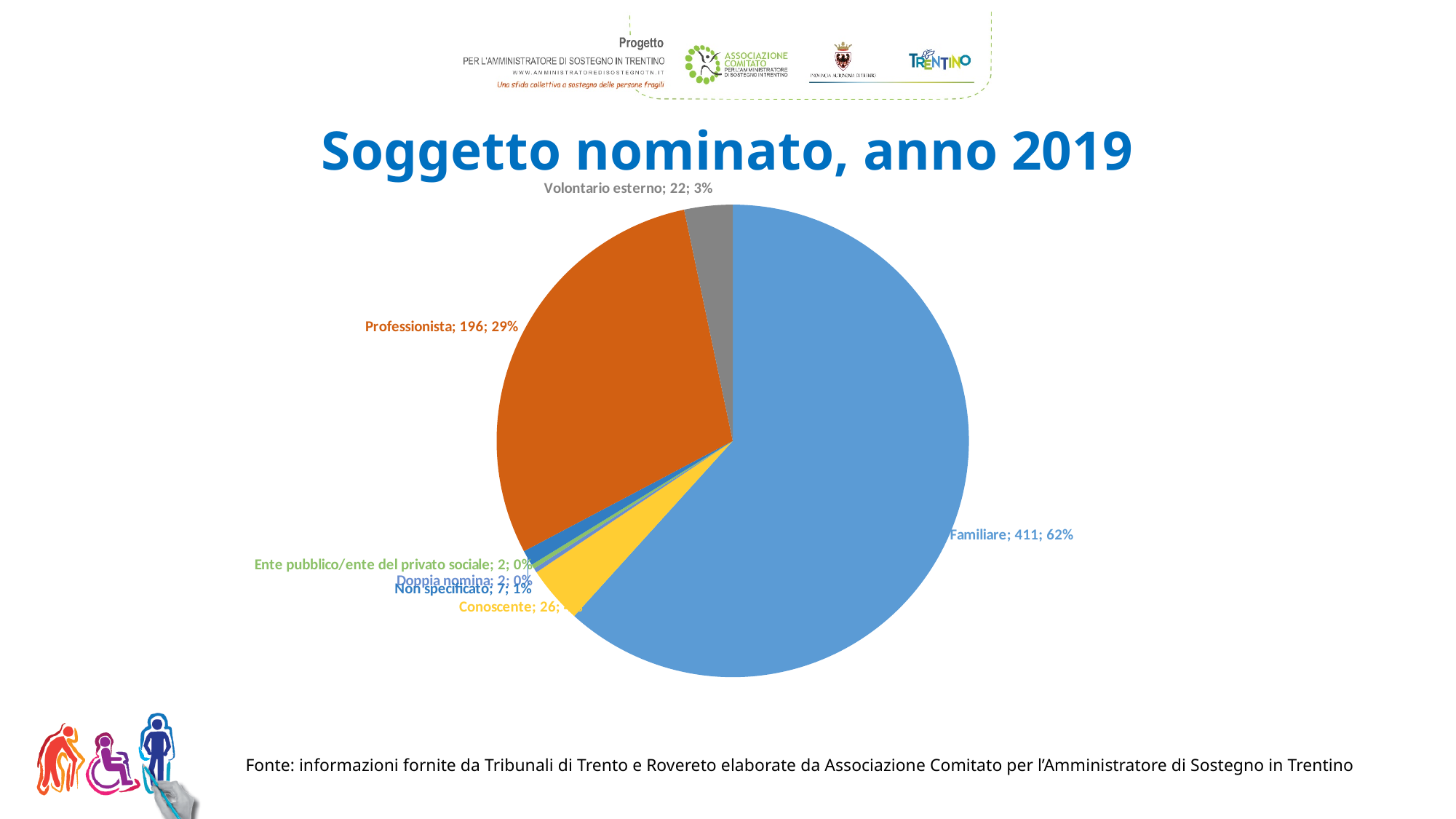
What is the difference between the values for Familiare and Professionista? 215 How many slices does the pie chart have? 7 What share of the pie does Professionista represent? 29% Which category has the largest slice? Familiare What kind of chart is shown on the slide? pie chart What is the value for Non specificato? 7 What is the value for Professionista? 196 Which is larger, the value for Conoscente or the value for Volontario esterno? Conoscente What is the value for Conoscente? 26 What is the value for Familiare? 411 What is the title of the chart? Soggetto nominato, anno 2019 What is the value for Volontario esterno? 22